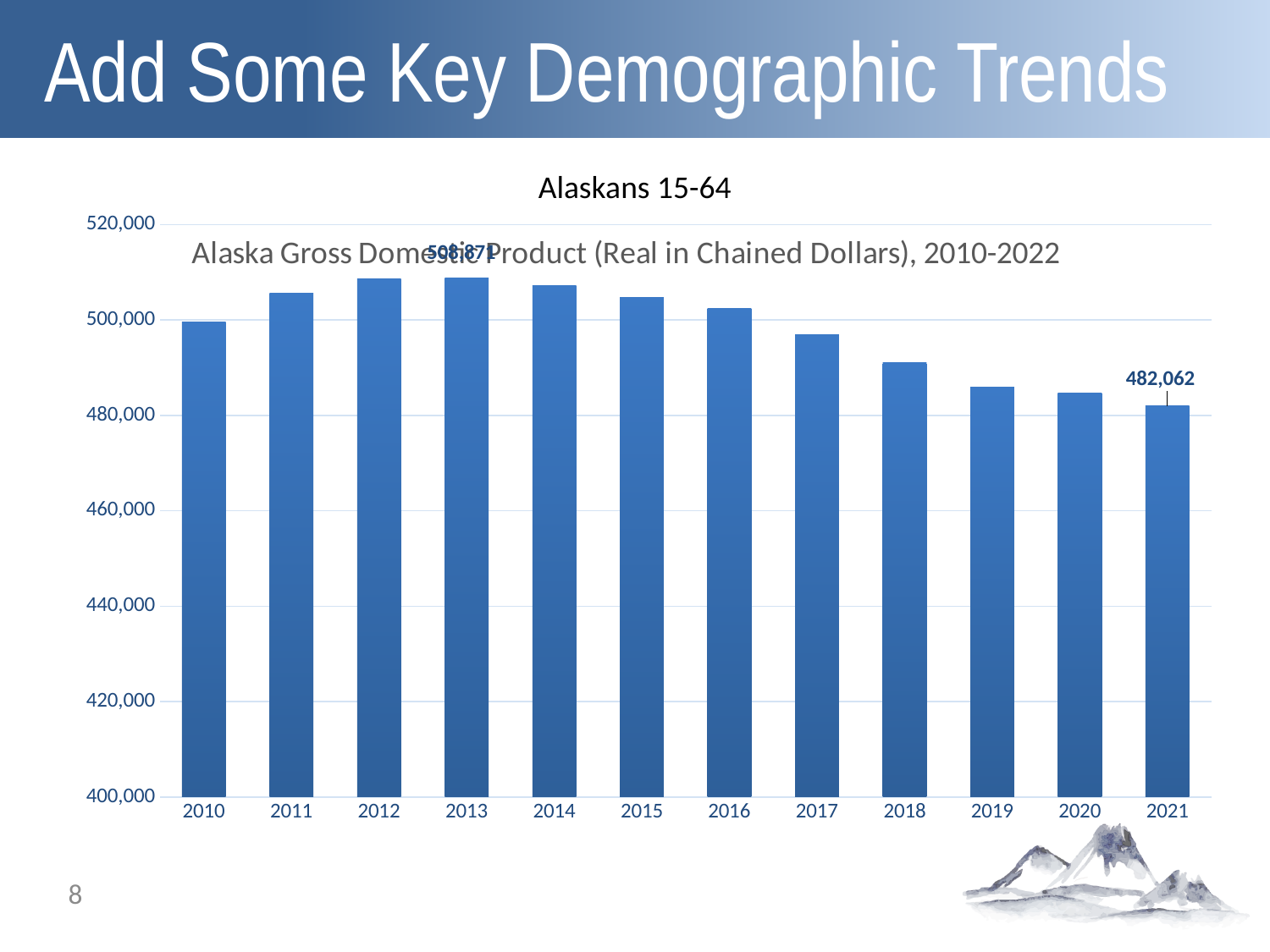
What is the value for 2021 in the Alaskans 15-64 chart? 482,062 Which year has the larger value, 2018 or 2019? 2018 What is the title of the chart? Alaskans 15-64 What kind of chart is shown on the slide? bar chart Which year has the larger value, 2012 or 2020? 2012 Do the values rise or fall from 2013 to 2021? fall Is the value for 2017 greater or less than 500,000? less Which year has the lowest value in the Alaskans 15-64 chart? 2021 Is the value for 2015 greater or less than 500,000? greater Is the value for 2018 greater or less than 480,000? greater How many years are shown on the x axis of the chart? 12